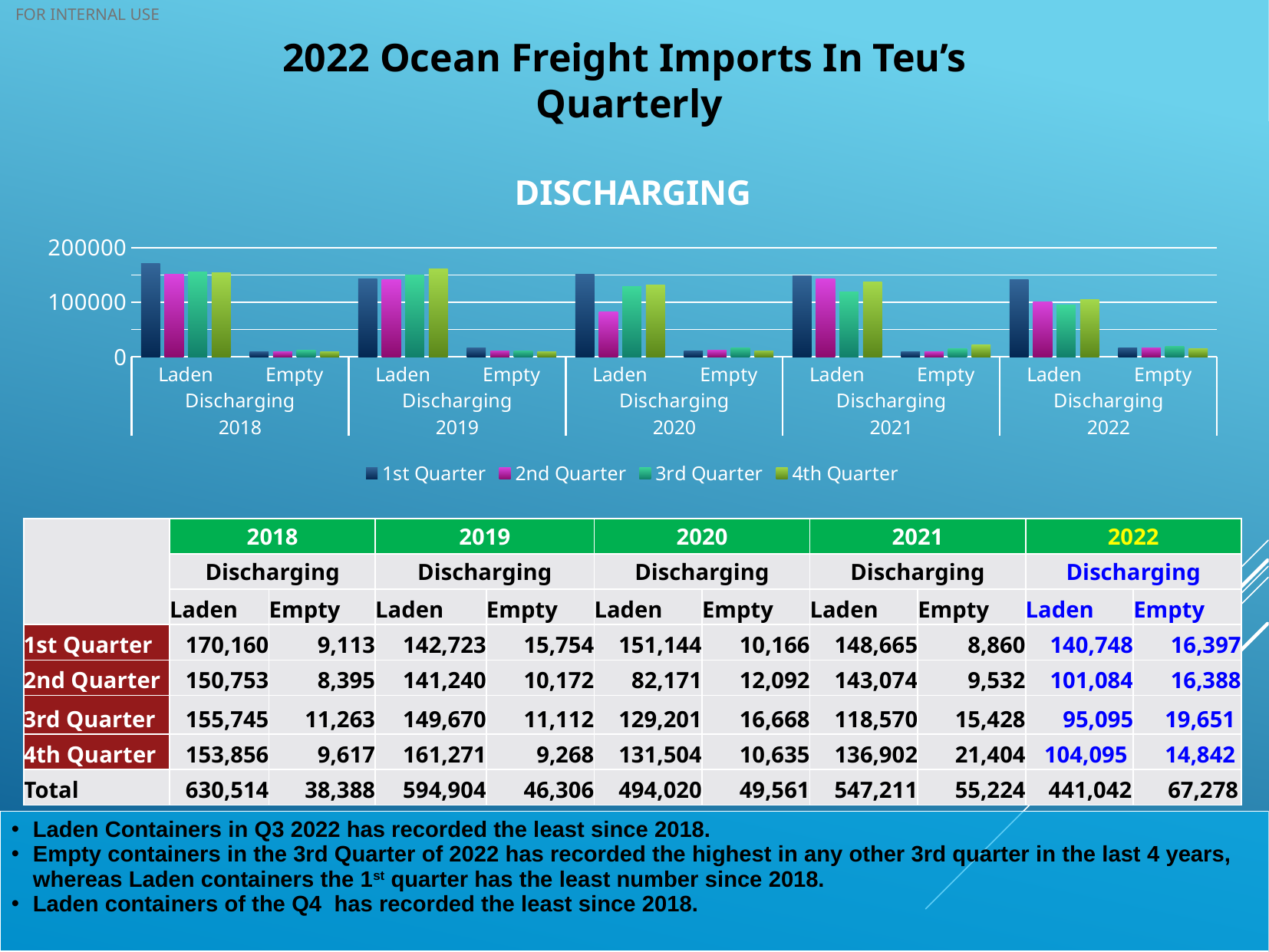
How many years are shown along the x axis of the DISCHARGING chart? 5 What is the difference between the 1st Quarter and 2nd Quarter Laden Discharging values in 2022? 39,664 What is the 3rd Quarter value for Empty Discharging in 2022? 19,651 What is the total Laden Discharging value for 2022 across all four quarters? 441,042 How many series does the legend of the DISCHARGING chart list? 4 Which is larger, the 4th Quarter Laden Discharging value in 2018 or in 2019? 2019 What is the difference between the 4th Quarter Empty Discharging values in 2021 and 2020? 10,769 In which year is the 2nd Quarter Laden Discharging value the lowest? 2020 In which year is the 1st Quarter Laden Discharging value the highest? 2018 Is the 1st Quarter Laden Discharging value for 2018 greater or less than 100000? greater What is the 1st Quarter value for Laden Discharging in 2018? 170,160 What kind of chart is shown under the title DISCHARGING? bar chart